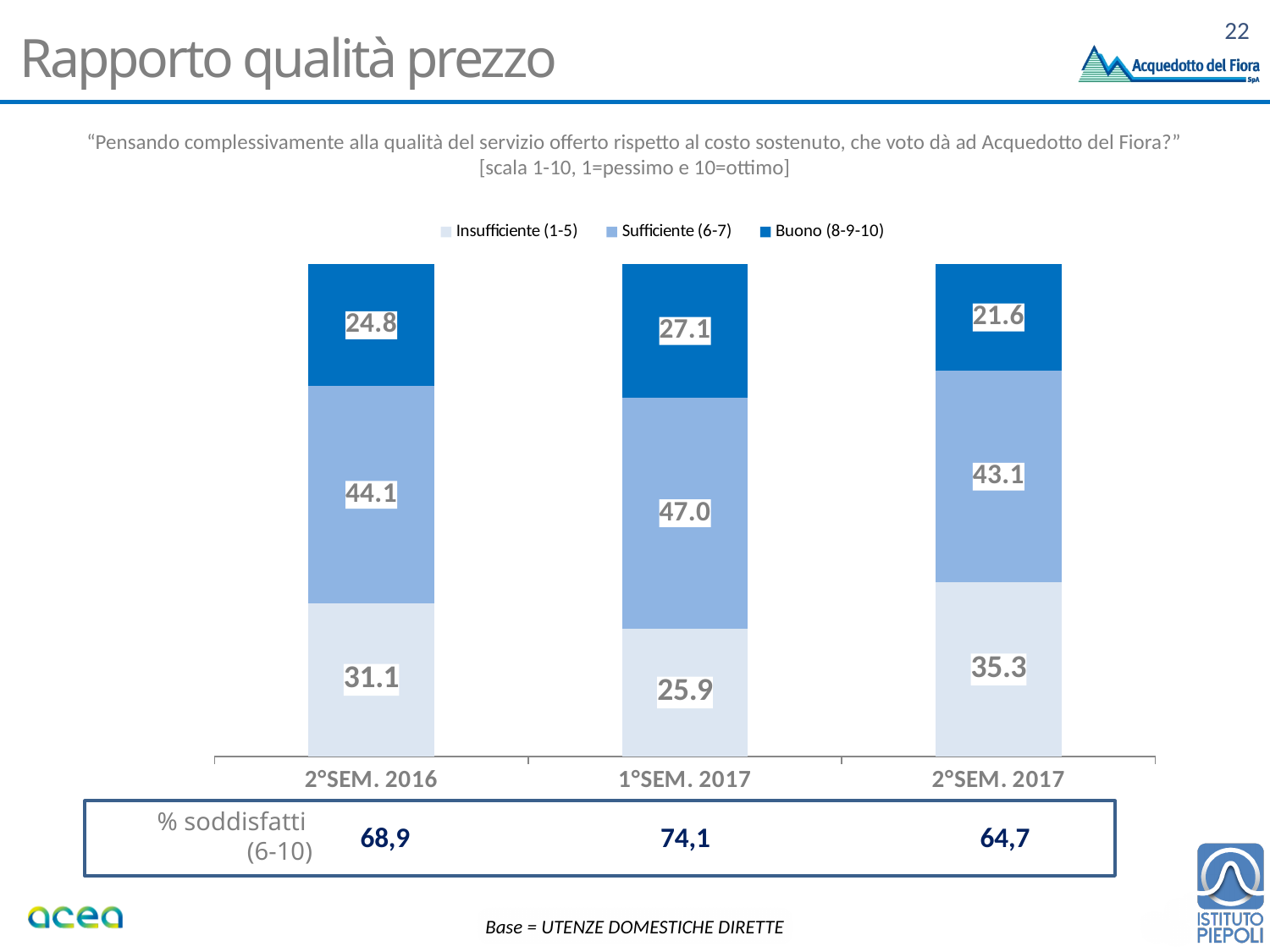
What is the difference between the Insufficiente (1-5) values for 2°SEM. 2017 and 1°SEM. 2017? 9.4 How many series does the legend list? 3 What type of chart is shown on the slide? Stacked bar chart How many categories are shown on the x axis? 3 Which category has the lowest value for Buono (8-9-10)? 2°SEM. 2017 Does the Buono (8-9-10) value rise or fall from 1°SEM. 2017 to 2°SEM. 2017? Fall What is the total of the stacked bar for 2°SEM. 2016? 100.0 Which is larger: Buono (8-9-10) for 2°SEM. 2016 or for 1°SEM. 2017? 1°SEM. 2017 Which category has the highest value for Sufficiente (6-7)? 1°SEM. 2017 What is the value of Insufficiente (1-5) for 2°SEM. 2017? 35.3 What is the value of Sufficiente (6-7) for 2°SEM. 2016? 44.1 What is the value of Buono (8-9-10) for 1°SEM. 2017? 27.1